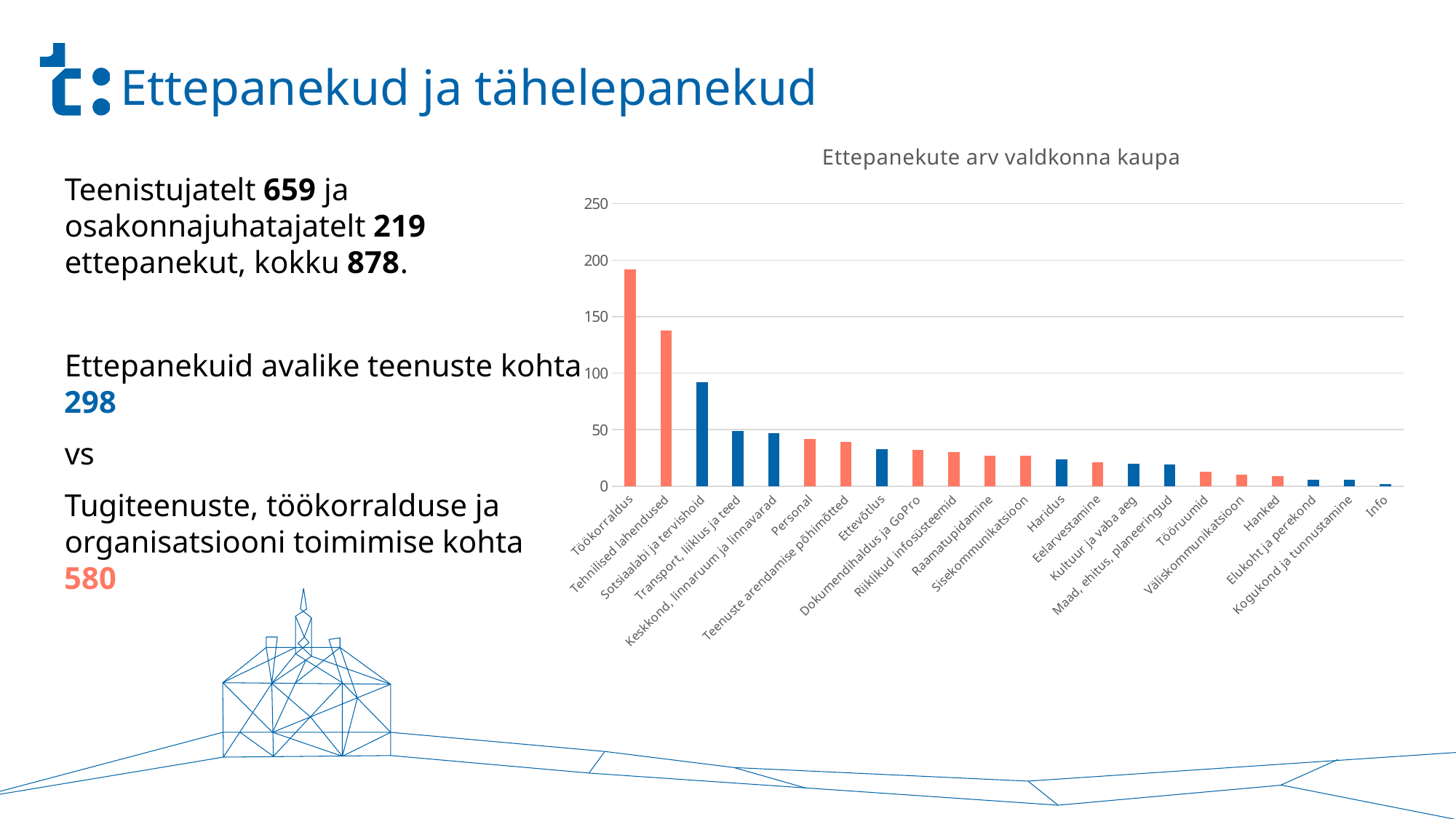
What is the title of the chart? Ettepanekute arv valdkonna kaupa How many different bar colours are used in the chart? 2 Is the value for Tehnilised lahendused greater or less than 100? greater Which category has the lowest value in the chart? Info Which category has the highest value in the chart? Töökorraldus Which is larger, the value for Töökorraldus or the value for Tehnilised lahendused? Töökorraldus Do the values rise or fall moving from left to right along the x axis? fall Is the value for Töökorraldus greater or less than 150? greater What kind of chart is shown on the slide? bar chart Is the value for Personal greater or less than 50? less How many categories are shown on the x axis of the chart? 22